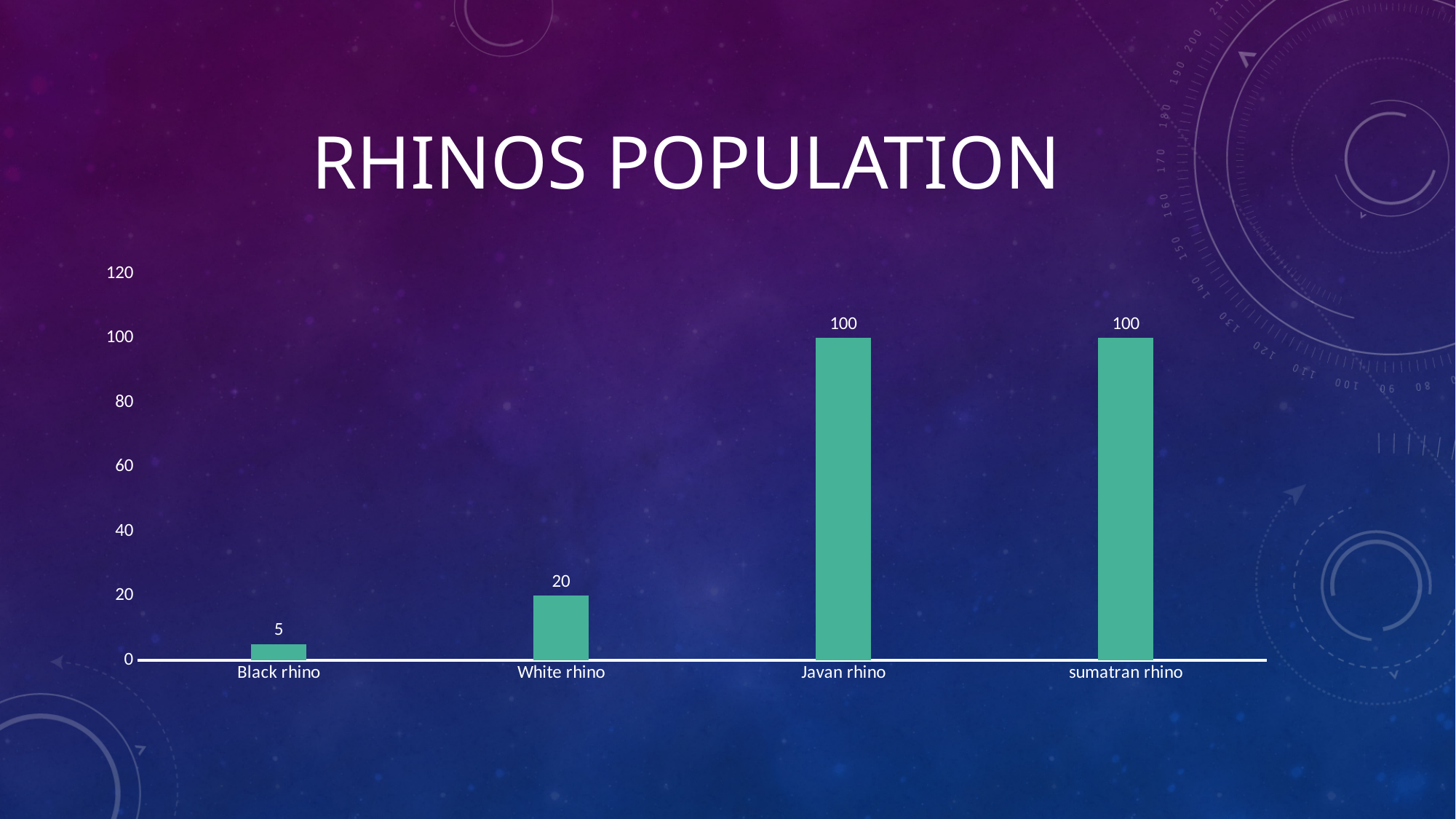
What is the value for sumatran rhino? 100 What is the value for White rhino? 20 What kind of chart is shown on the slide? bar chart Is the value for Javan rhino greater or less than 80? greater What is the value for Black rhino? 5 What is the difference between the values for White rhino and Black rhino? 15 What is the value for Javan rhino? 100 Which category has the lowest value? Black rhino Which is larger, the value for White rhino or the value for Black rhino? White rhino What is the title of the slide? RHINOS POPULATION What is the difference between the values for Javan rhino and White rhino? 80 How many categories are shown on the x axis? 4